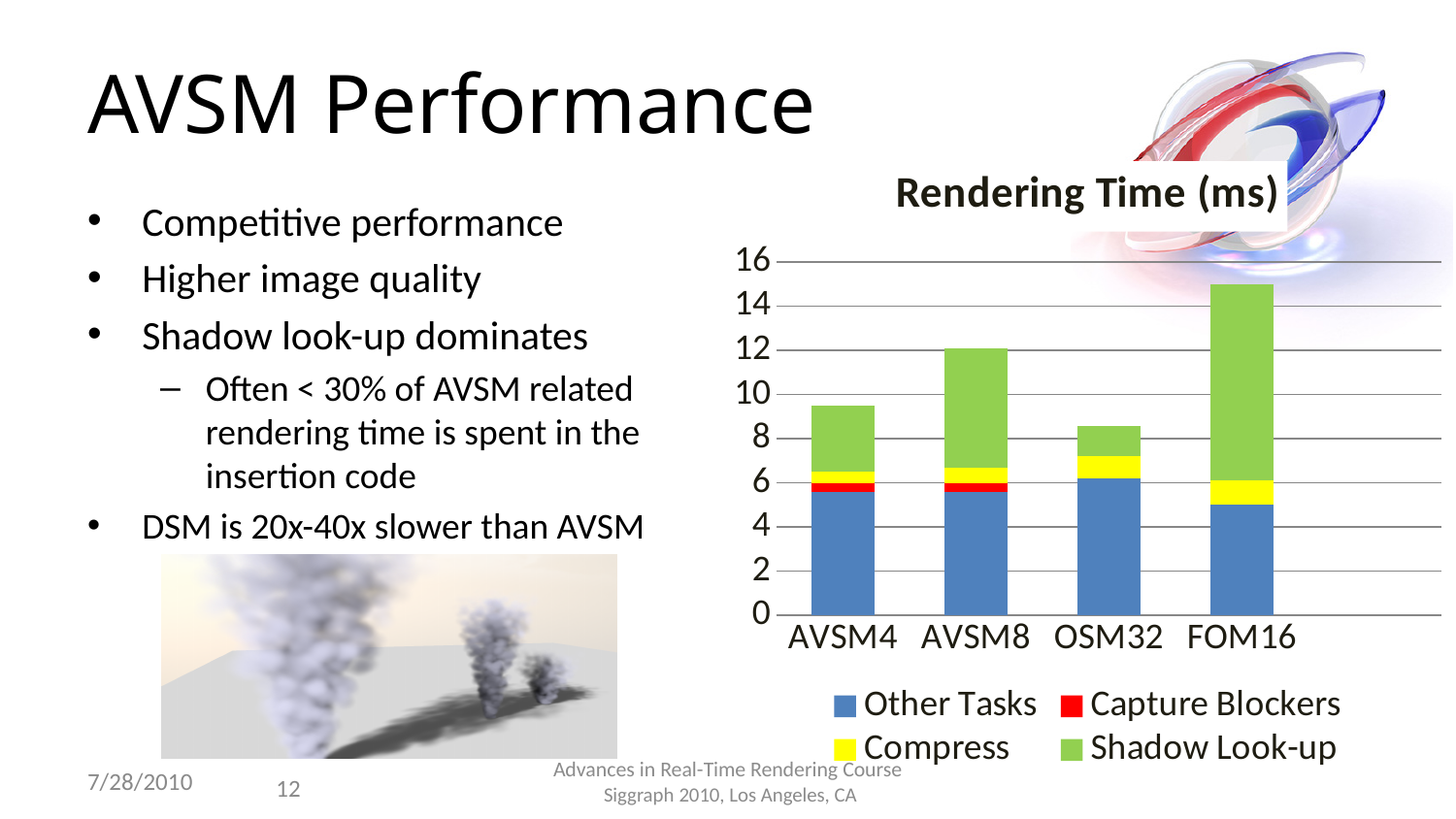
Which category has the largest Shadow Look-up segment? FOM16 What is the title of the chart? Rendering Time (ms) How many series does the chart legend list? 4 Is the total rendering time for FOM16 greater or less than 14? greater Which category has the lowest total rendering time? OSM32 Which colour represents Shadow Look-up in the chart legend? Green Which has a larger total rendering time, AVSM4 or AVSM8? AVSM8 How many categories are shown on the x axis of the chart? 4 Which category has the highest total rendering time? FOM16 What kind of chart is shown on the slide? Stacked bar chart Is the total rendering time for AVSM4 greater or less than 10? less Is the total rendering time for OSM32 greater or less than 10? less